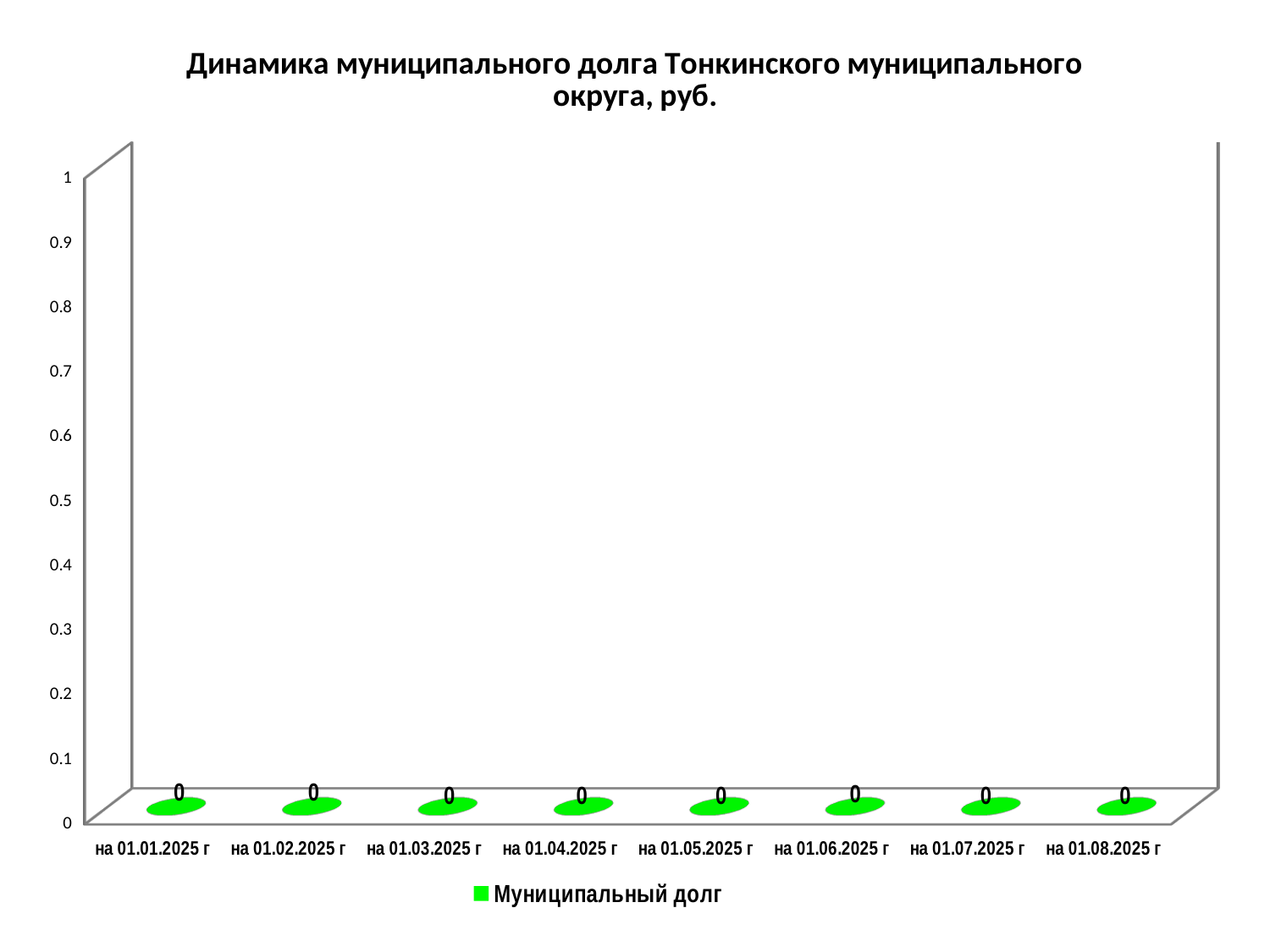
What is the difference between the values на 01.03.2025 г and на 01.07.2025 г? 0 What is the value of Муниципальный долг на 01.05.2025 г? 0 What is the title of the chart? Динамика муниципального долга Тонкинского муниципального округа, руб. How many dates (categories) are shown on the x axis? 8 What is the name of the series shown in the legend? Муниципальный долг Do the values rise, fall, or stay the same from 01.01.2025 to 01.08.2025? Stay the same What is the value of Муниципальный долг на 01.01.2025 г? 0 Is the value for на 01.04.2025 г greater or less than 0.5? less What is the value of Муниципальный долг на 01.08.2025 г? 0 How many series does the legend list? 1 What kind of chart is shown on the slide? Bar chart